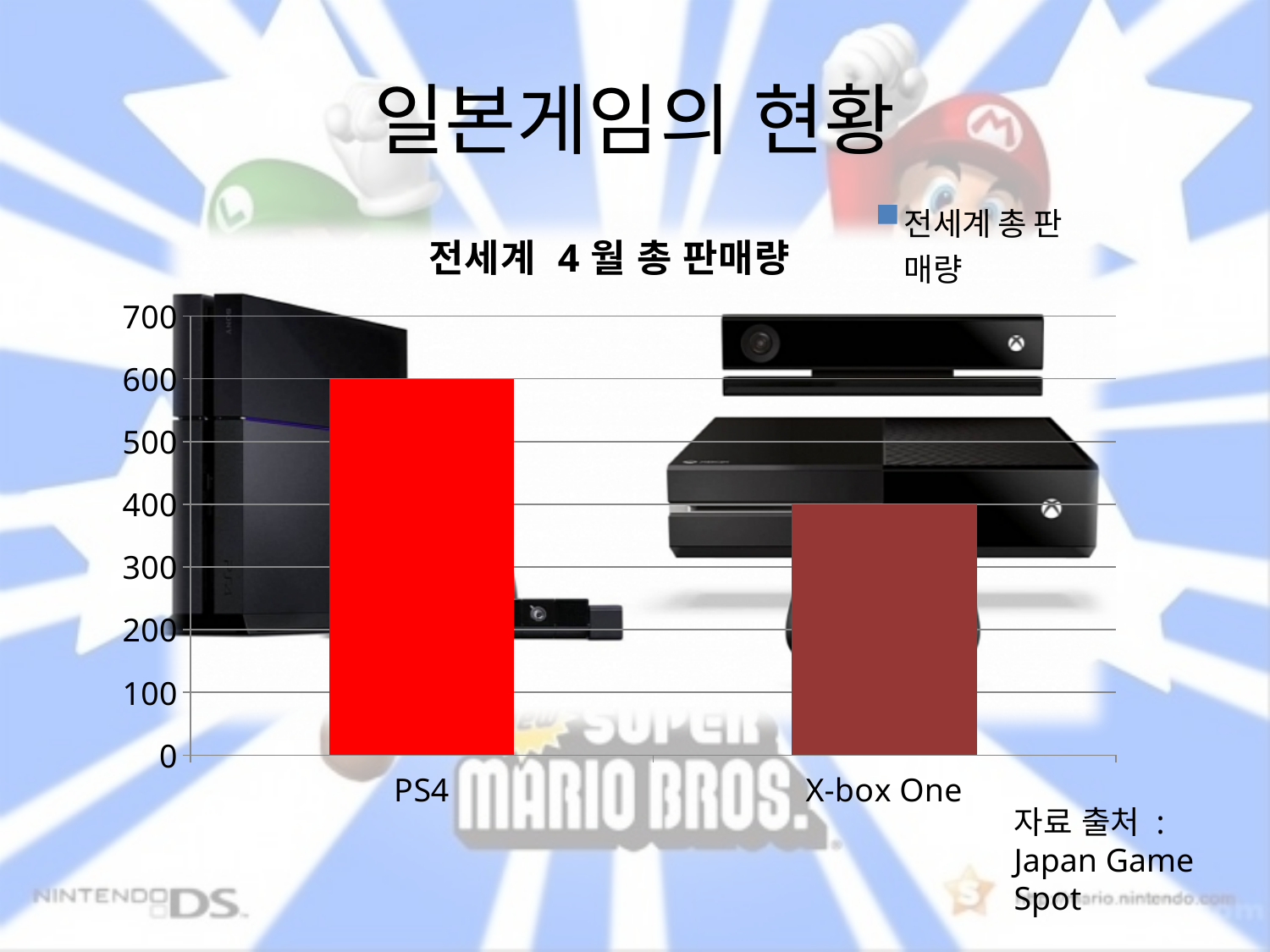
How many categories are shown in the chart? 2 What is the value for X-box One in the chart? 400 Which is larger, the value for PS4 or the value for X-box One? PS4 What is the value for PS4 in the chart? 600 Which category has the lowest value in the chart? X-box One Is the value for X-box One greater or less than 500? less Is the value for PS4 greater or less than 500? greater What is the title of the chart? 전세계 4월 총 판매량 What kind of chart is shown on the slide? bar chart Which category has the highest value in the chart? PS4 How many series does the legend list? 1 What is the difference between the values for PS4 and X-box One? 200